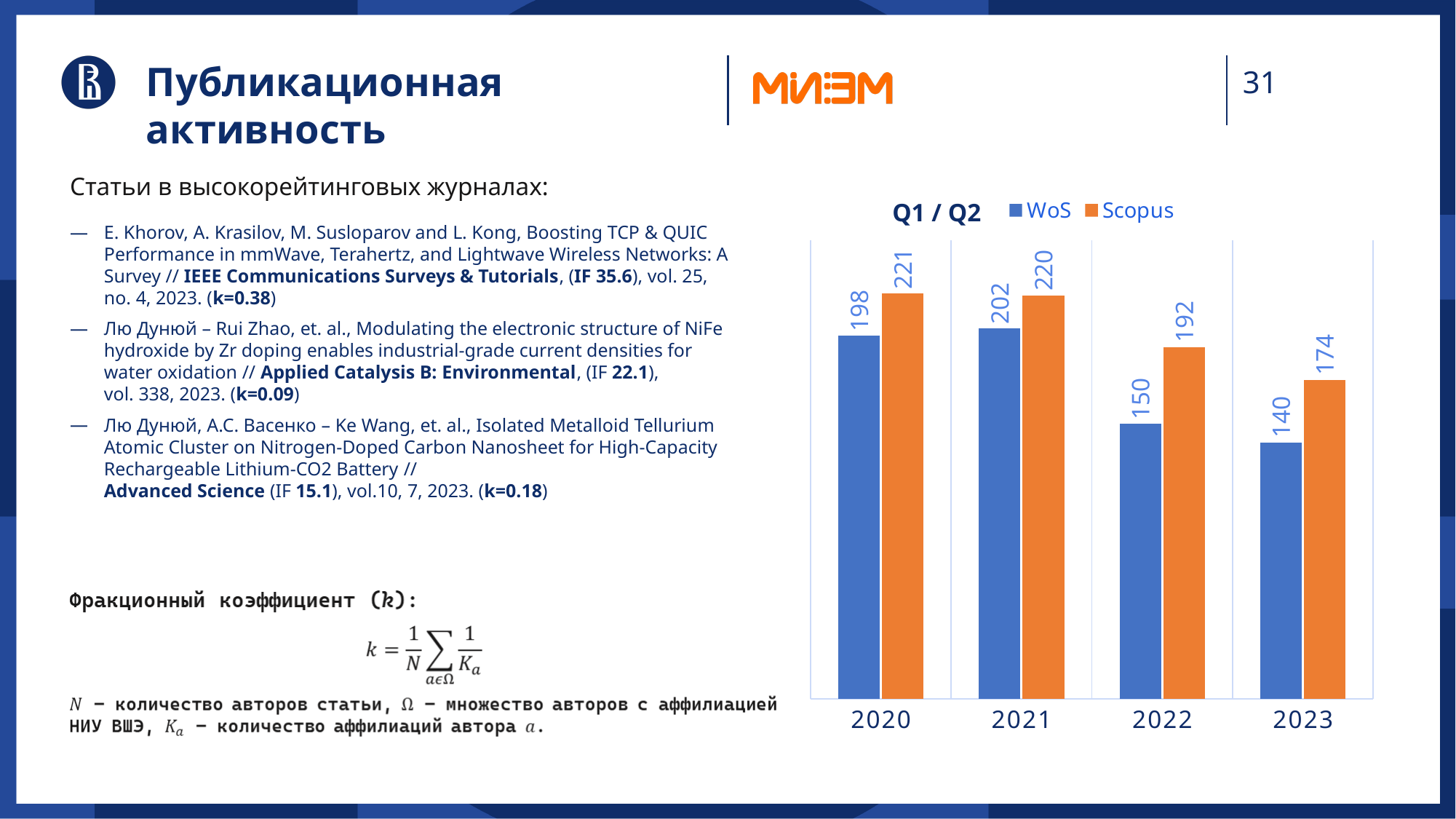
What is the WoS value for 2020? 198 Do the Scopus values rise or fall from 2021 to 2023? fall What is the difference between the Scopus and WoS values in 2022? 42 How many series does the chart legend list? 2 What is the Scopus value for 2022? 192 What is the difference between the WoS values for 2021 and 2023? 62 What kind of chart is shown on the slide? bar chart What is the Scopus value for 2023? 174 Which year has the lowest Scopus value? 2023 Which is larger in 2020, the WoS value or the Scopus value? Scopus How many years are shown on the x axis of the chart? 4 Which year has the highest WoS value? 2021